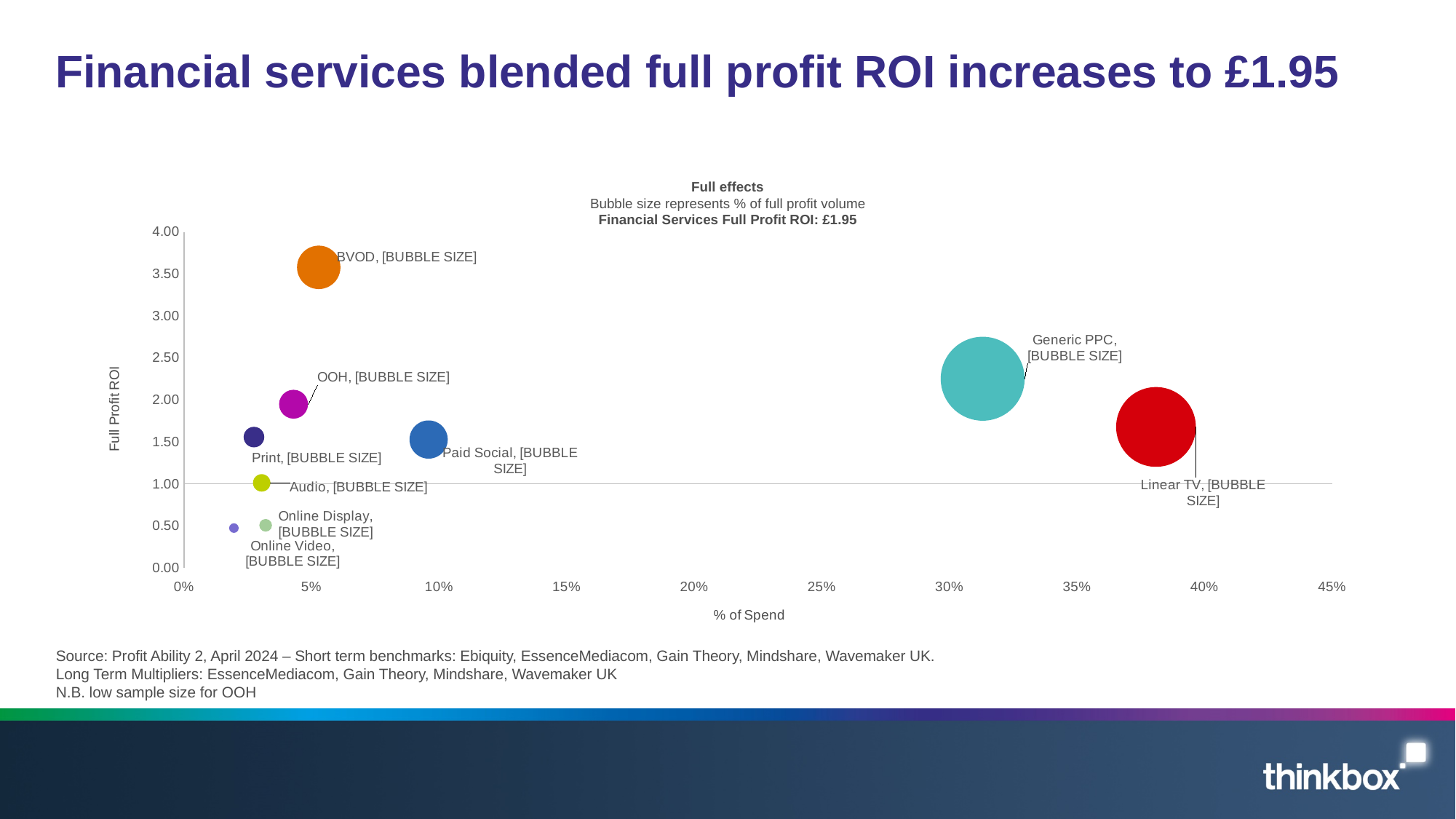
According to the chart subtitle, what does the bubble size represent? % of full profit volume Is the % of Spend for Linear TV greater or less than 35%? greater Which has the higher % of Spend, Paid Social or Print? Paid Social Which channel has the highest % of Spend? Linear TV Which has the higher Full Profit ROI, BVOD or Generic PPC? BVOD Is the Full Profit ROI for BVOD greater or less than 3.00? greater Is the % of Spend for Generic PPC greater or less than 25%? greater What kind of chart is shown on the slide? Bubble chart Which channel has the highest Full Profit ROI? BVOD How many media channels (bubbles) are plotted on the chart? 9